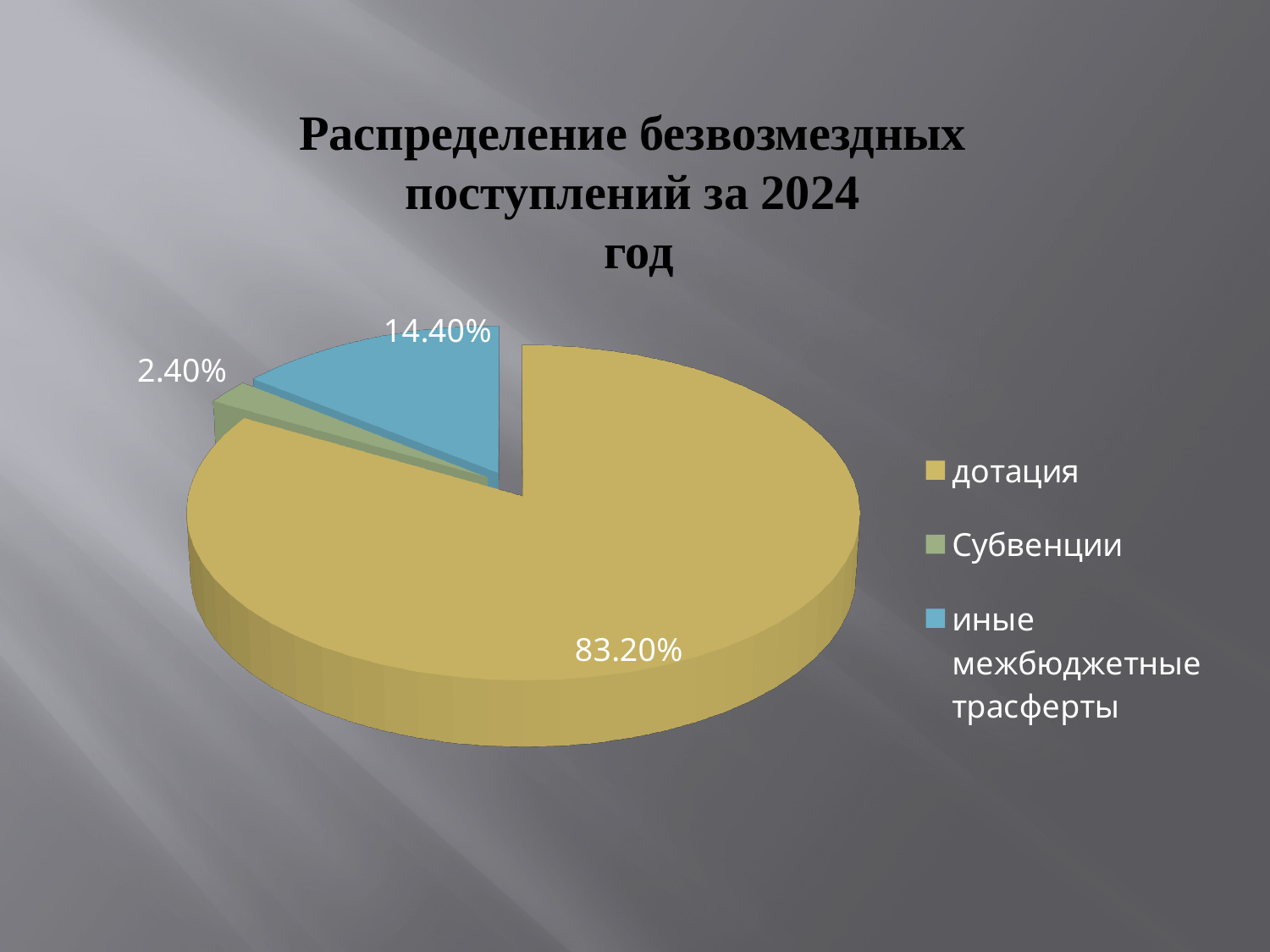
What is the title of the chart? Распределение безвозмездных поступлений за 2024 год What kind of chart is shown on the slide? pie chart Which category has the largest share of the pie? дотация What colour is the slice for дотация? yellow What share of the pie does дотация have? 83.20% What share of the pie does иные межбюджетные трасферты have? 14.40% What share of the pie does Субвенции have? 2.40% Which category has the smallest share of the pie? Субвенции What is the difference between the shares of дотация and иные межбюджетные трасферты? 68.80% How many slices does the pie chart have? 3 Which is larger, the share of Субвенции or the share of иные межбюджетные трасферты? иные межбюджетные трасферты What is the difference between the shares of иные межбюджетные трасферты and Субвенции? 12.00%